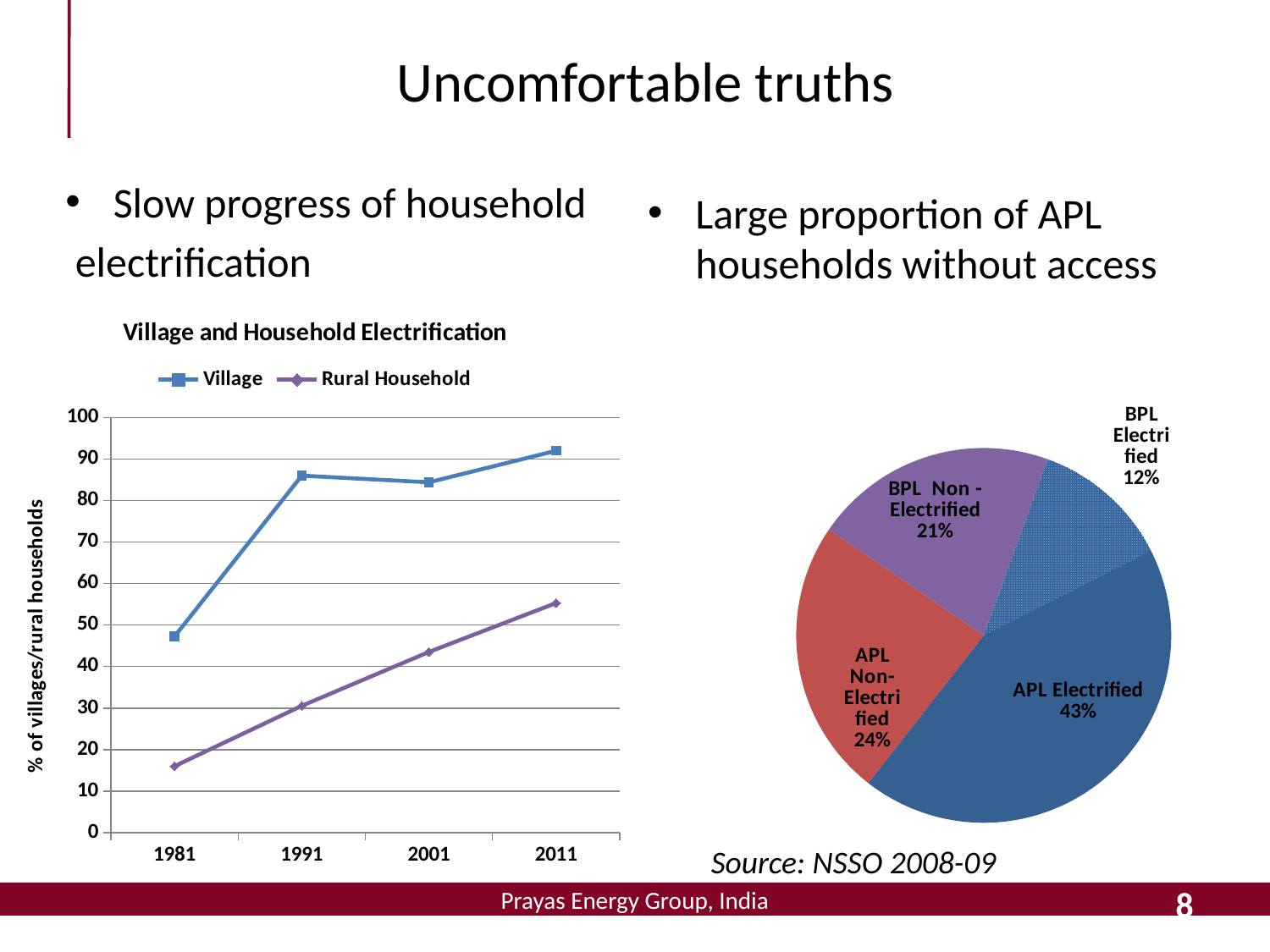
In the 'Village and Household Electrification' chart, how many series does the legend list? 2 In the 'Village and Household Electrification' chart, is the Rural Household value for 1981 greater or less than 20? less In the 'Village and Household Electrification' chart, is the Village value for 1991 greater or less than 80? greater In the 'Village and Household Electrification' chart, does the Rural Household series rise or fall from 1981 to 2011? rise In the 'Village and Household Electrification' chart, what type of chart is shown? line chart In the 'Village and Household Electrification' chart, how many years are plotted on the x axis? 4 In the 'Village and Household Electrification' chart, what is the y-axis label? % of villages/rural households In the 'Village and Household Electrification' chart, which series is higher in 2001, Village or Rural Household? Village In the 'Village and Household Electrification' chart, is the Rural Household value for 2011 greater or less than 50? greater In the pie chart on the right, what share is APL Electrified? 43% In the pie chart on the right, which slice is the smallest? BPL Electrified In the pie chart on the right, what is the difference between the APL Non-Electrified and BPL Non-Electrified shares? 3%